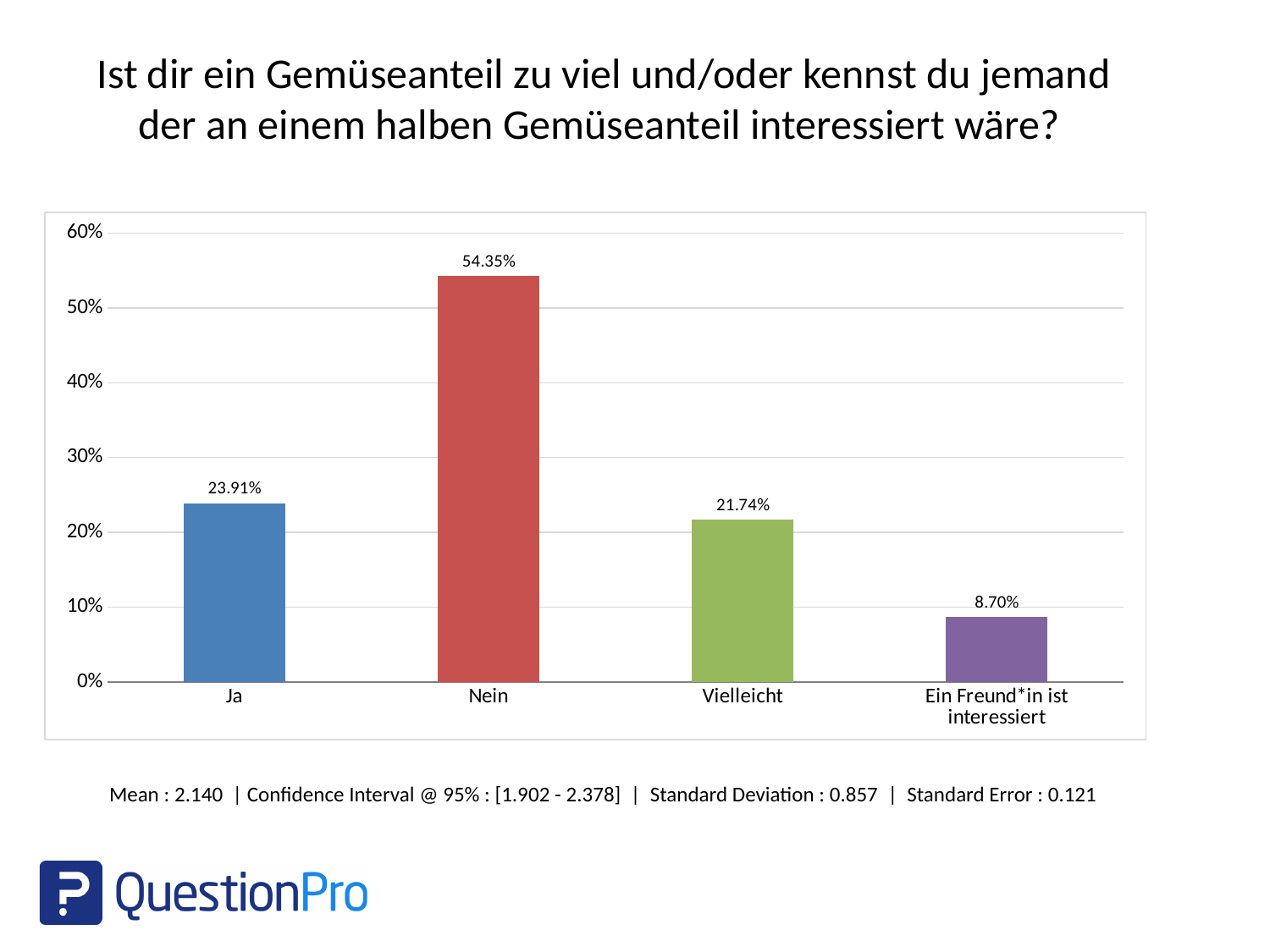
What colour is the bar for "Nein"? Red How many categories are shown on the x axis? 4 What is the value for "Ein Freund*in ist interessiert"? 8.70% Which category has the lowest value? Ein Freund*in ist interessiert What is the value for "Nein"? 54.35% What is the value for "Ja"? 23.91% What is the value for "Vielleicht"? 21.74% Is the value for "Nein" greater or less than 50%? greater Which category has the highest value? Nein What kind of chart is shown on the slide? Bar chart What is the difference between the values for "Nein" and "Ja"? 30.44% Which is larger, the value for "Ja" or the value for "Vielleicht"? Ja